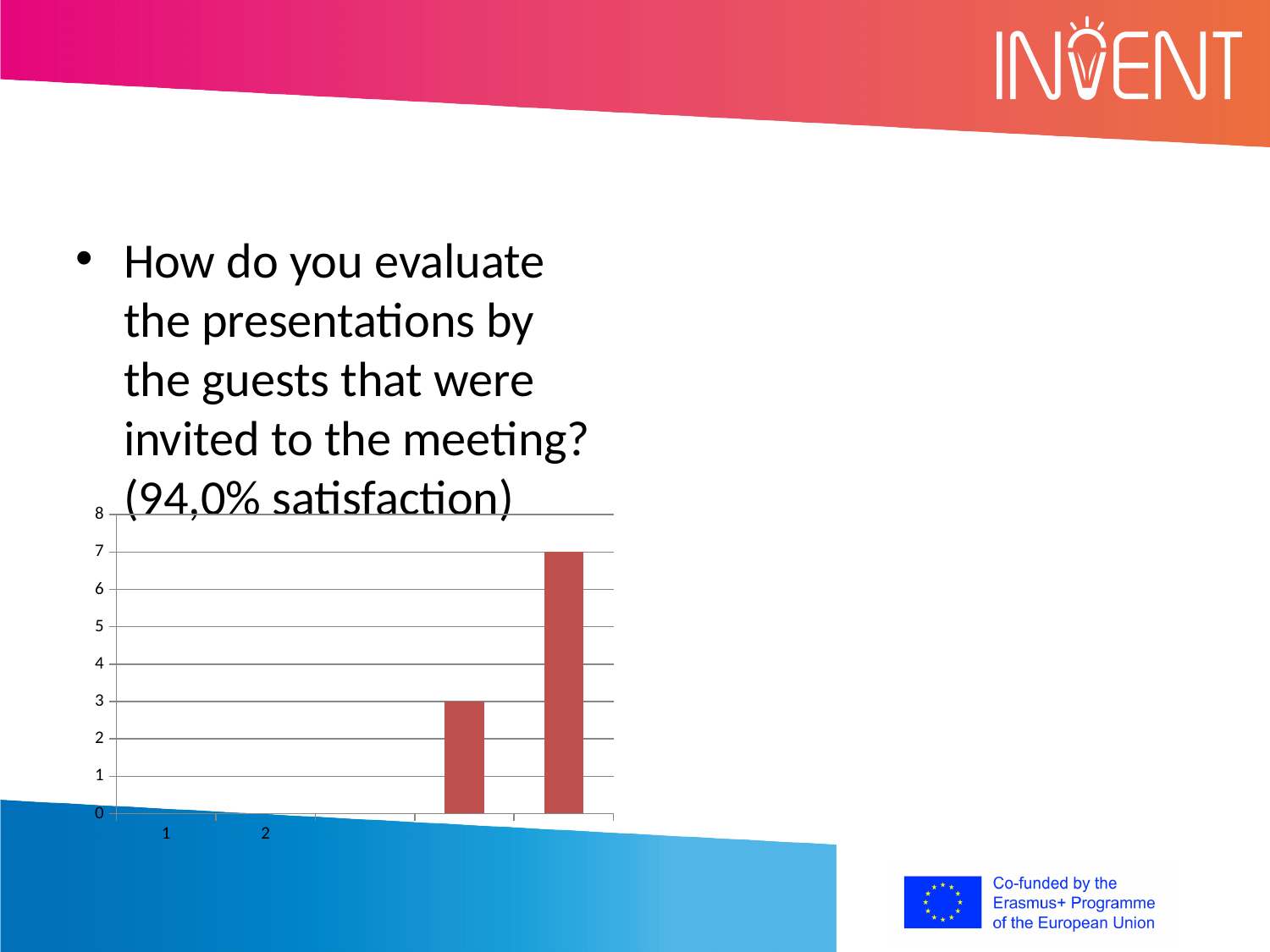
How many bars are plotted in the chart? 2 Is the value of the left bar greater or less than 4? less What value does the shortest bar in the chart reach? 3 What is the highest value shown on the vertical axis? 8 Is the value of the rightmost bar greater or less than 5? greater What value does the tallest bar in the chart reach? 7 What colour are the bars in the chart? red What kind of chart is shown on the slide? bar chart What is the difference between the taller bar and the shorter bar in the chart? 4 Do the bar values rise or fall from left to right? rise Which bar is taller, the left bar or the right bar? the right bar